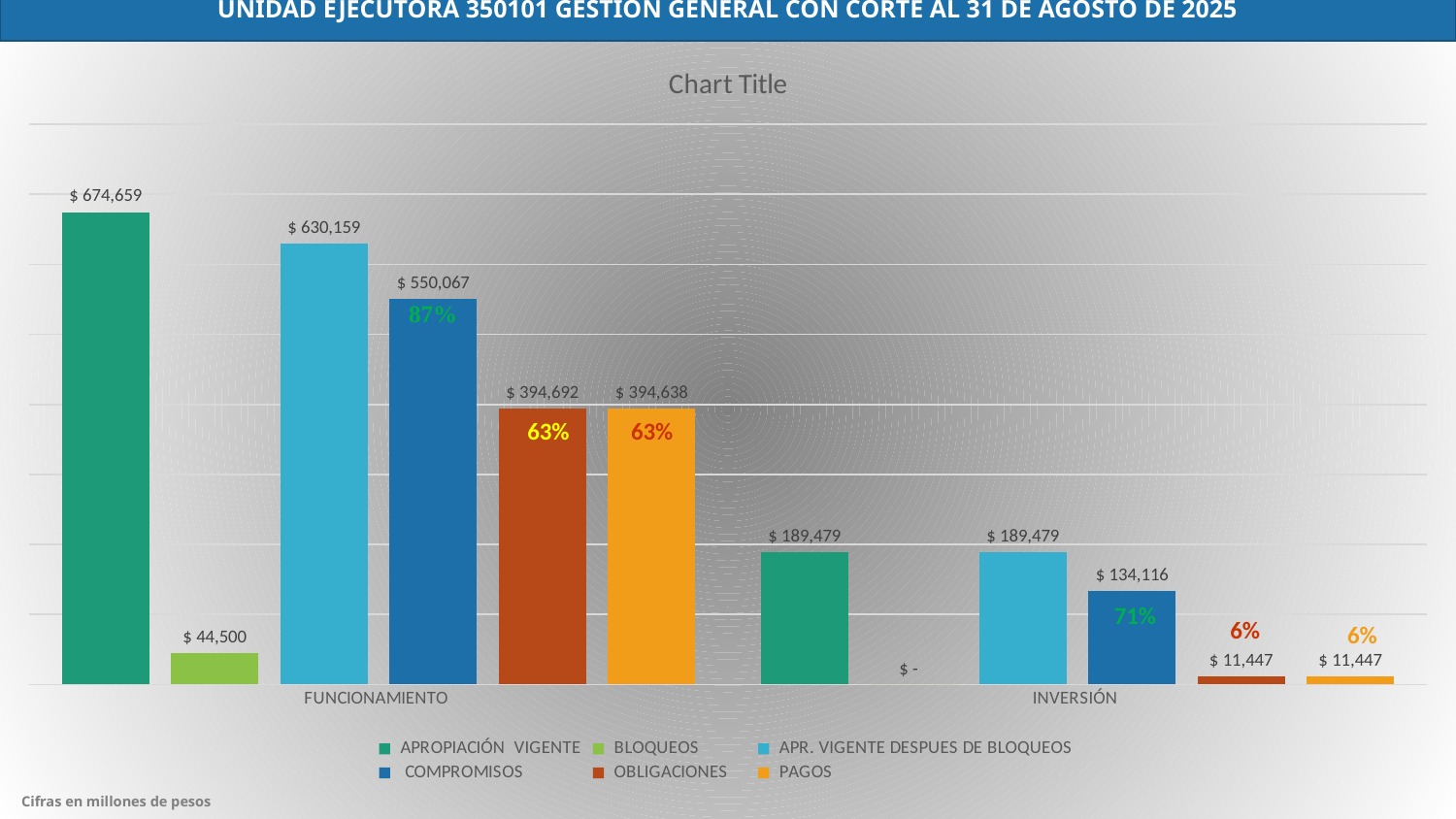
Which series has the highest value for FUNCIONAMIENTO? APROPIACIÓN VIGENTE What is the difference between APROPIACIÓN VIGENTE and APR. VIGENTE DESPUES DE BLOQUEOS for FUNCIONAMIENTO? $ 44,500 Which series has the lowest value for FUNCIONAMIENTO? BLOQUEOS What is the value of APROPIACIÓN VIGENTE for FUNCIONAMIENTO? $ 674,659 What is the value of COMPROMISOS for INVERSIÓN? $ 134,116 How many series does the legend list? 6 Which is larger for FUNCIONAMIENTO: COMPROMISOS or OBLIGACIONES? COMPROMISOS What type of chart is shown on the slide? Bar chart What is the value of BLOQUEOS for FUNCIONAMIENTO? $ 44,500 What percentage is shown on the COMPROMISOS bar for FUNCIONAMIENTO? 87% What is the value of PAGOS for INVERSIÓN? $ 11,447 What is the difference between APR. VIGENTE DESPUES DE BLOQUEOS and COMPROMISOS for INVERSIÓN? $ 55,363